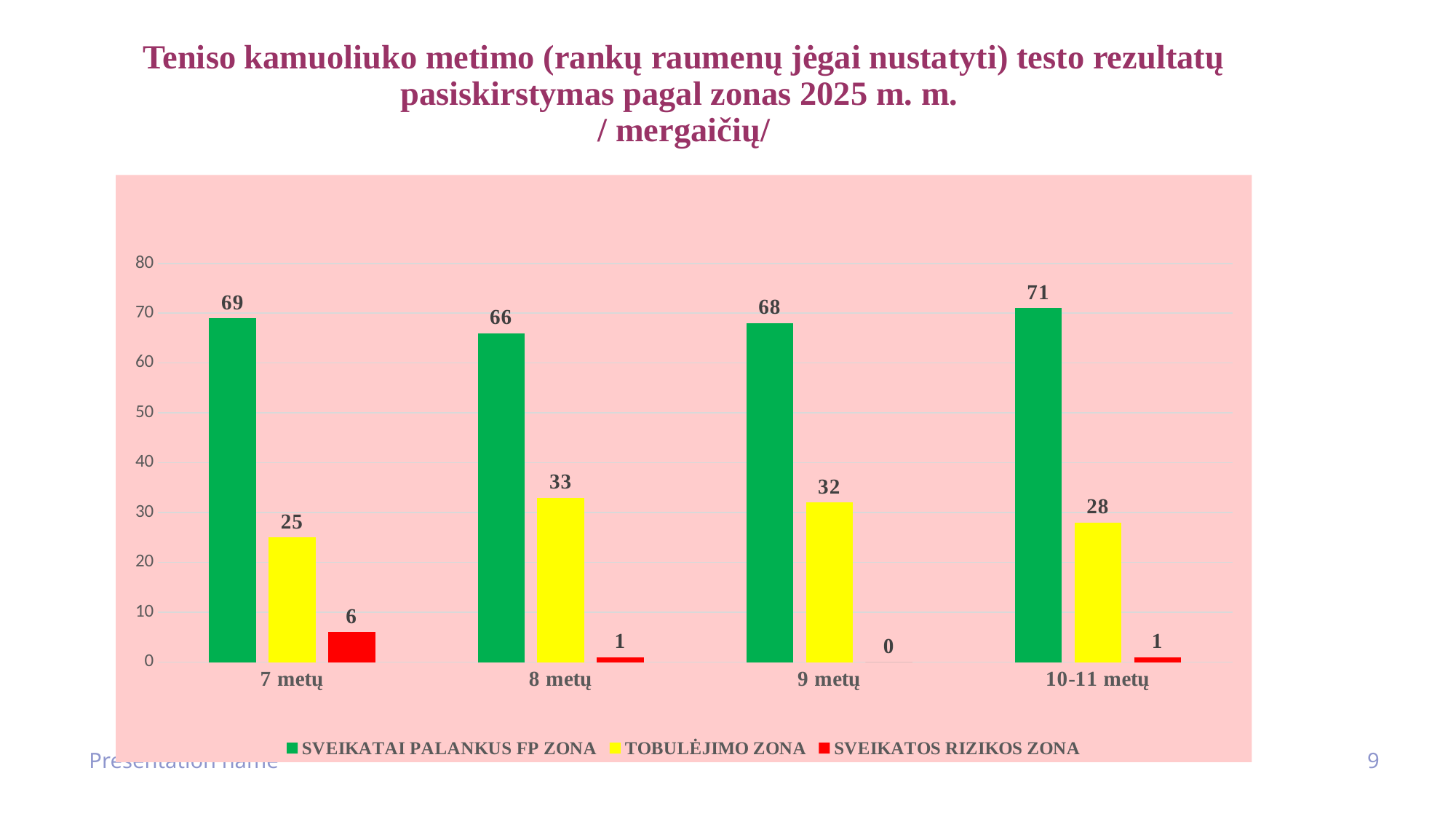
What is the difference between the SVEIKATAI PALANKUS FP ZONA value and the TOBULĖJIMO ZONA value for 9 metų? 36 How many series does the legend list? 3 What is the value of SVEIKATAI PALANKUS FP ZONA for 7 metų? 69 Which age group has the lowest value for TOBULĖJIMO ZONA? 7 metų What is the value of TOBULĖJIMO ZONA for 8 metų? 33 What colour represents SVEIKATOS RIZIKOS ZONA in the chart? Red Which is larger: the SVEIKATOS RIZIKOS ZONA value for 7 metų or for 8 metų? 7 metų What kind of chart is shown on the slide? Bar chart Which age group has the highest value for SVEIKATAI PALANKUS FP ZONA? 10-11 metų What is the value of SVEIKATOS RIZIKOS ZONA for 9 metų? 0 How many age groups are shown on the x axis? 4 What is the value of TOBULĖJIMO ZONA for 10-11 metų? 28